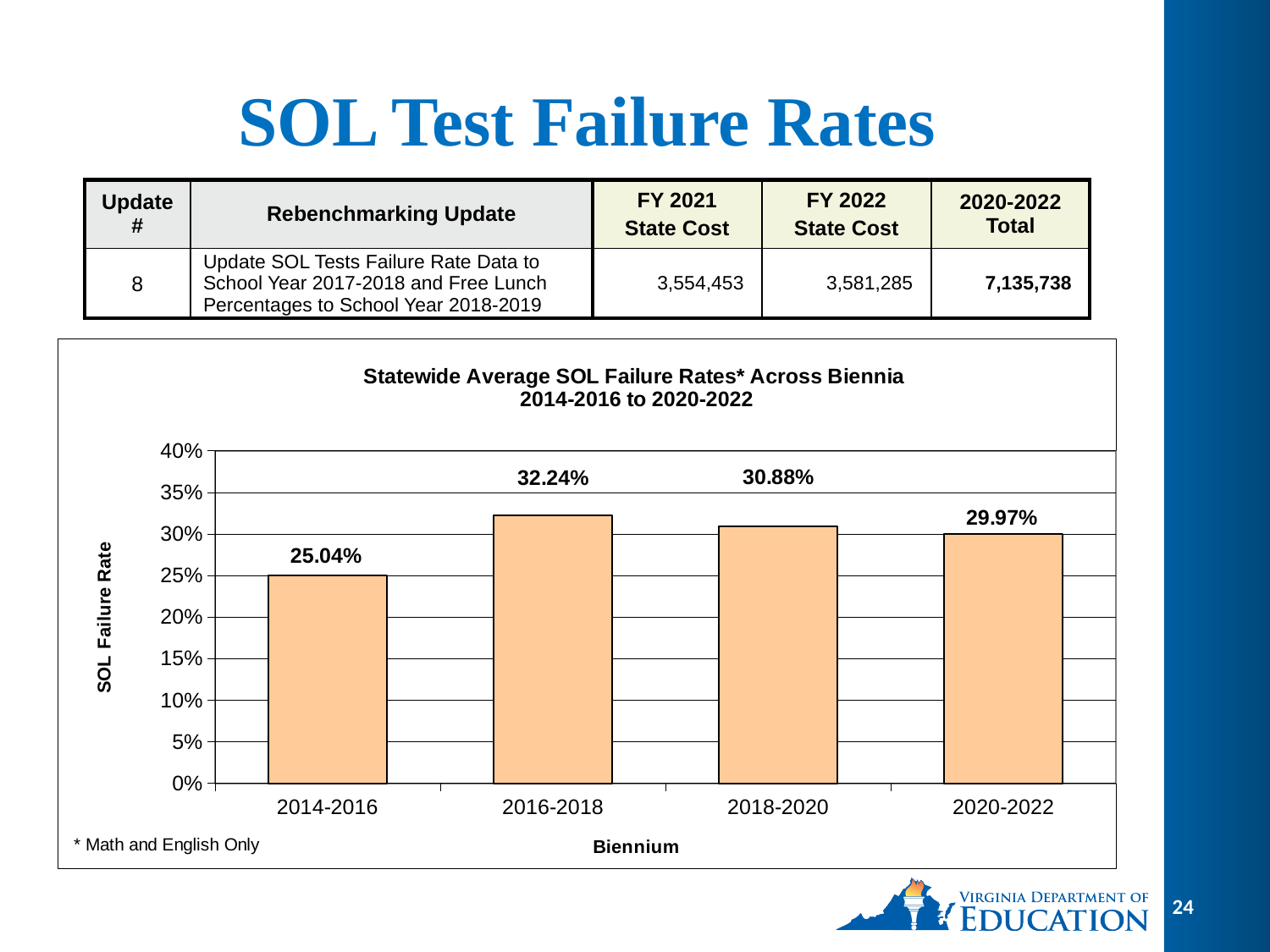
What kind of chart is used to show the SOL failure rates? bar chart How many biennia are shown in the chart? 4 Do the SOL failure rates rise or fall from 2016-2018 to 2020-2022? fall What is the difference between the SOL failure rates for 2016-2018 and 2014-2016? 7.20% What is the SOL failure rate for the 2018-2020 biennium? 30.88% Which biennium has the lowest SOL failure rate? 2014-2016 Which biennium has a higher SOL failure rate, 2018-2020 or 2020-2022? 2018-2020 What is the SOL failure rate for the 2020-2022 biennium? 29.97% What is the SOL failure rate for the 2014-2016 biennium? 25.04% What is the label on the y axis of the chart? SOL Failure Rate Is the SOL failure rate for 2016-2018 greater or less than 30%? greater Which biennium has the highest SOL failure rate? 2016-2018